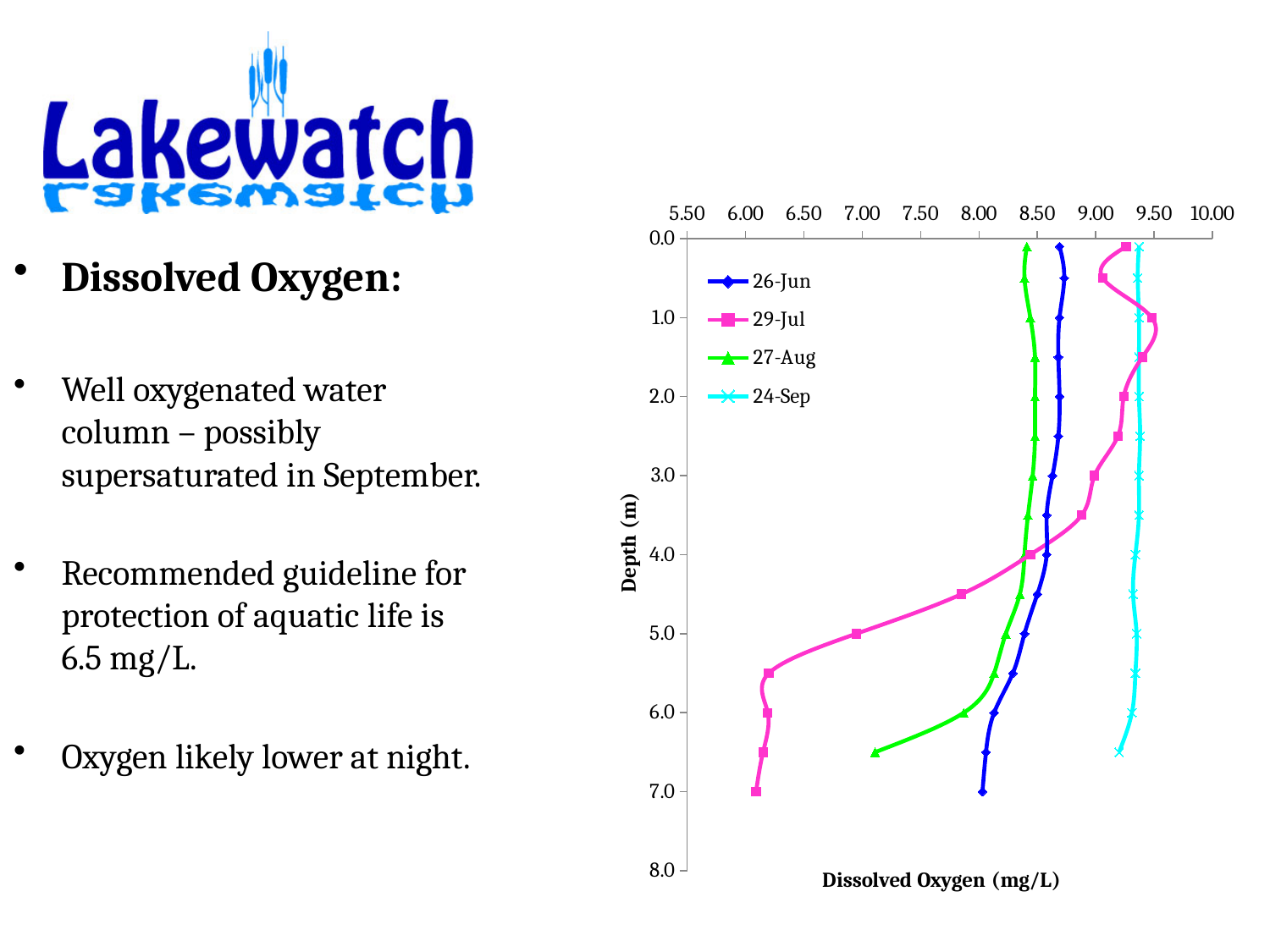
How many series does the chart legend list? 4 Which series has the highest dissolved oxygen value at a depth of 6.5 m? 24-Sep For the 29-Jul series, does dissolved oxygen increase or decrease as depth increases from 3.0 m to 7.0 m? decrease At a depth of 7.0 m, which series has the larger dissolved oxygen value, 26-Jun or 29-Jul? 26-Jun Is the dissolved oxygen value for 24-Sep at a depth of 0.0 m greater or less than 9.00? greater At a depth of 5.0 m, which series has the larger dissolved oxygen value, 24-Sep or 29-Jul? 24-Sep Is the dissolved oxygen value for 26-Jun at a depth of 7.0 m greater or less than 8.50? less Is the dissolved oxygen value for 29-Jul at a depth of 7.0 m greater or less than 6.50? less What kind of chart is shown on the slide? line chart What is the title of the chart's y axis? Depth (m) What is the title of the chart's x axis? Dissolved Oxygen (mg/L)